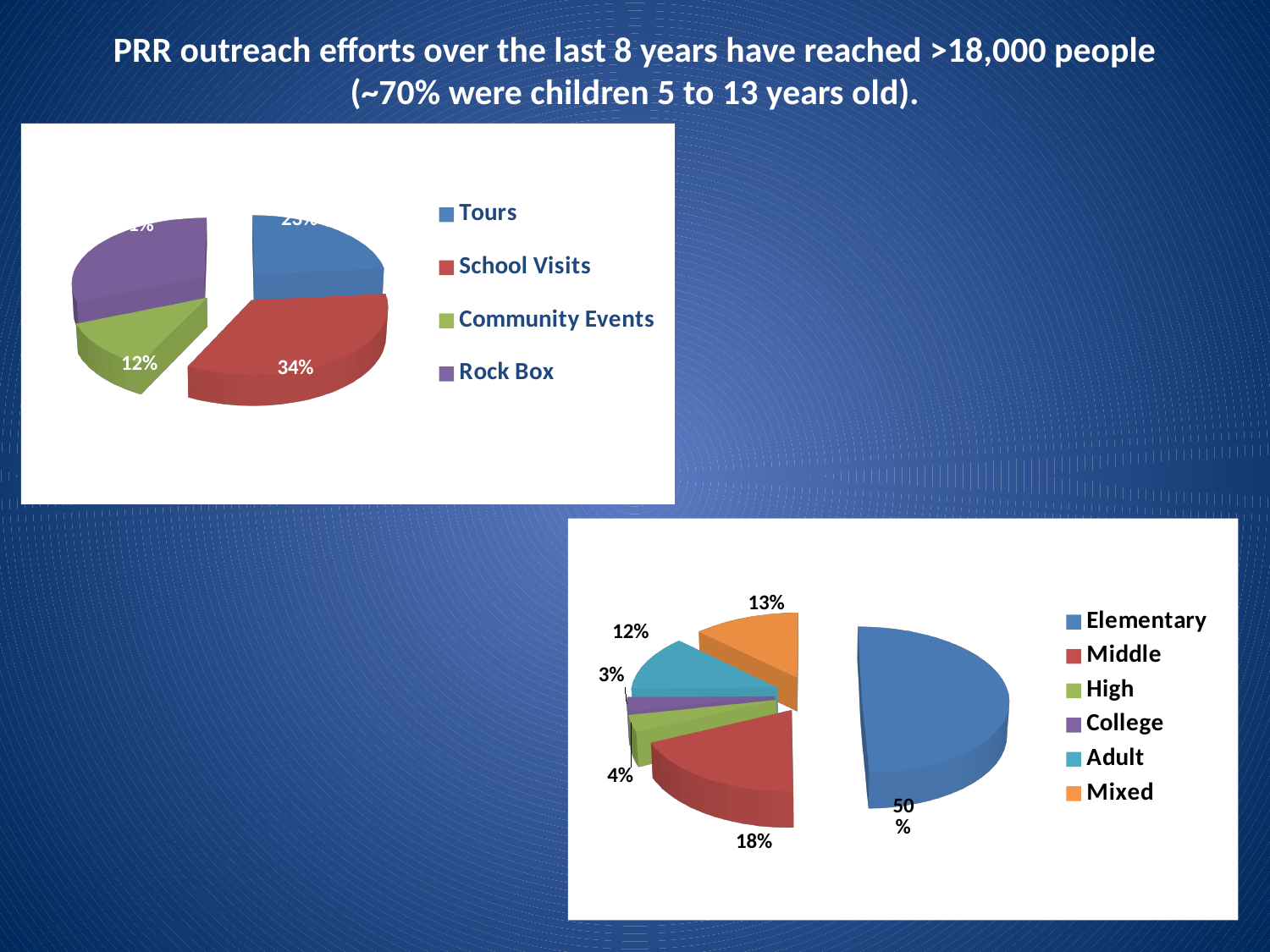
In the bottom-right pie chart, what is the difference in percentage points between Mixed and Adult? 1 percentage point In the bottom-right pie chart, what share is labelled for Elementary? 50% In the top-left pie chart, what share is labelled for Community Events? 12% In the bottom-right pie chart, which category has the smallest share? College In the top-left pie chart, what share is labelled for School Visits? 34% What kind of chart is the top-left chart? Pie chart In the bottom-right pie chart, what share is labelled for Middle? 18% How many categories does the legend of the bottom-right pie chart list? 6 In the top-left pie chart, which is larger, School Visits or Community Events? School Visits In the bottom-right pie chart, which category has the largest share? Elementary In the top-left pie chart, what is the difference in percentage points between School Visits and Community Events? 22 percentage points How many categories does the legend of the top-left pie chart list? 4